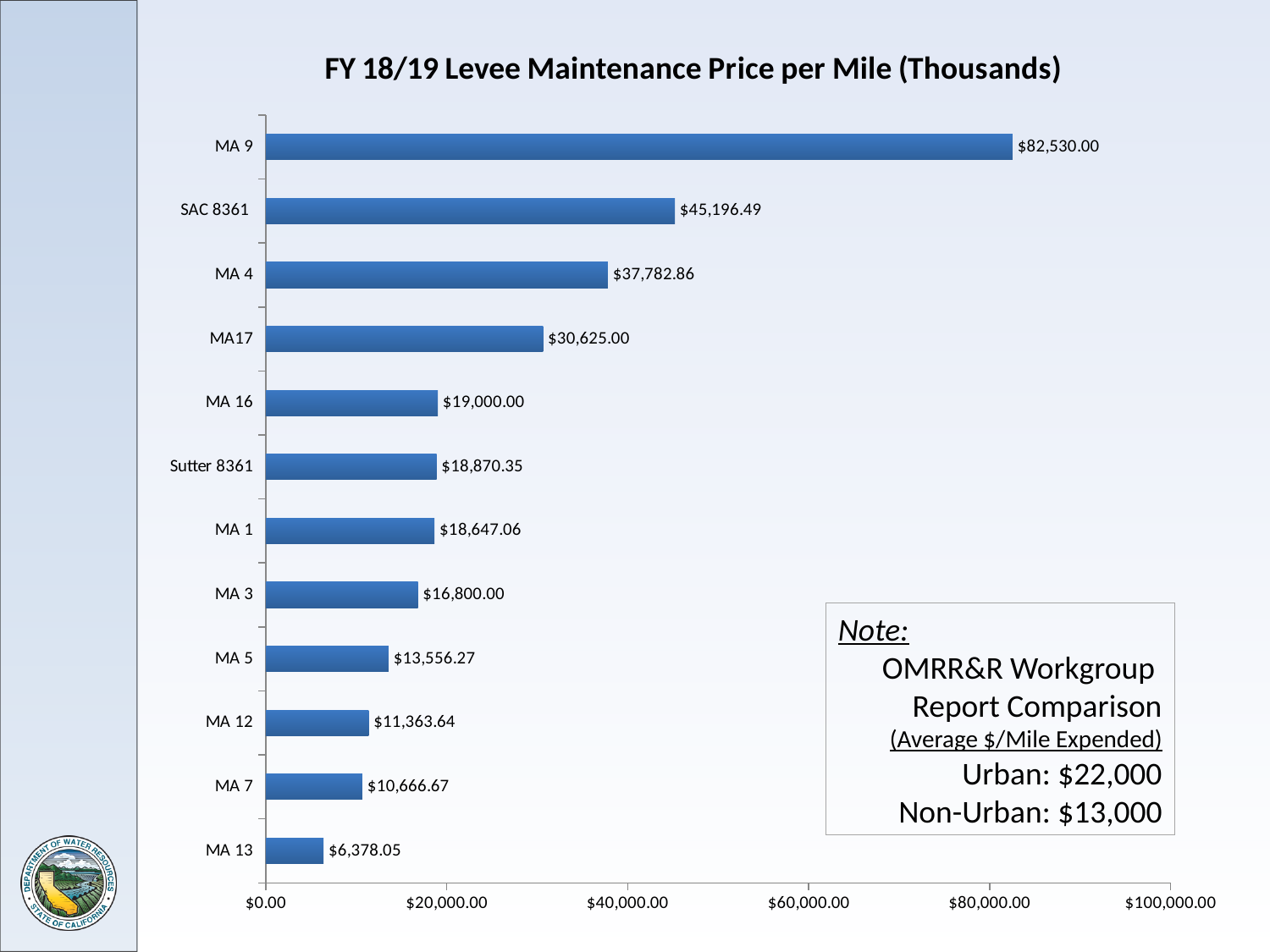
How many categories are shown in the chart? 12 Which category has the lowest price per mile? MA 13 What is the difference between the values for MA 9 and SAC 8361? $37,333.51 What is the levee maintenance price per mile for MA 9? $82,530.00 What kind of chart is shown on the slide? Bar chart What is the title of the chart? FY 18/19 Levee Maintenance Price per Mile (Thousands) What is the value shown for MA 12? $11,363.64 Which has a larger value, MA 3 or MA 7? MA 3 What is the difference between the values for MA 4 and MA17? $7,157.86 What is the value shown for Sutter 8361? $18,870.35 Is the value for MA 5 greater or less than $20,000.00? less Which category has the highest price per mile? MA 9